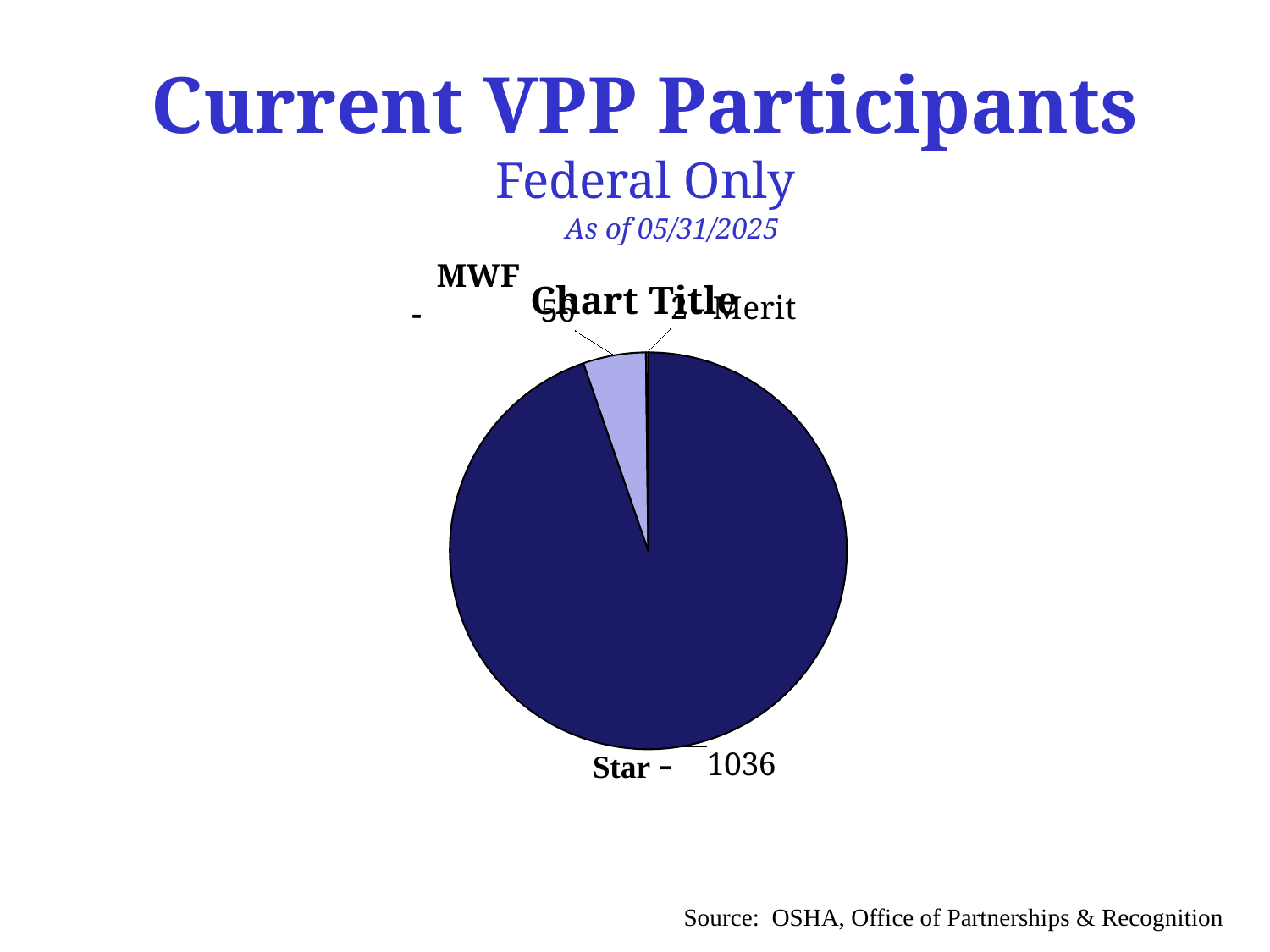
How many slices does the pie chart have? 3 Which is larger, the MWF slice or the Merit slice? MWF What colour is the Star slice of the pie? dark navy blue What kind of chart is shown on the slide? pie chart What is the total of all three values in the pie chart? 1094 What is the value shown for Merit? 2 Which category has the largest slice of the pie? Star What is the value shown for MWF? 56 Which category has the smallest slice of the pie? Merit What placeholder title text appears above the pie chart? Chart Title What is the difference between the Star value and the MWF value? 980 What is the value shown for Star? 1036